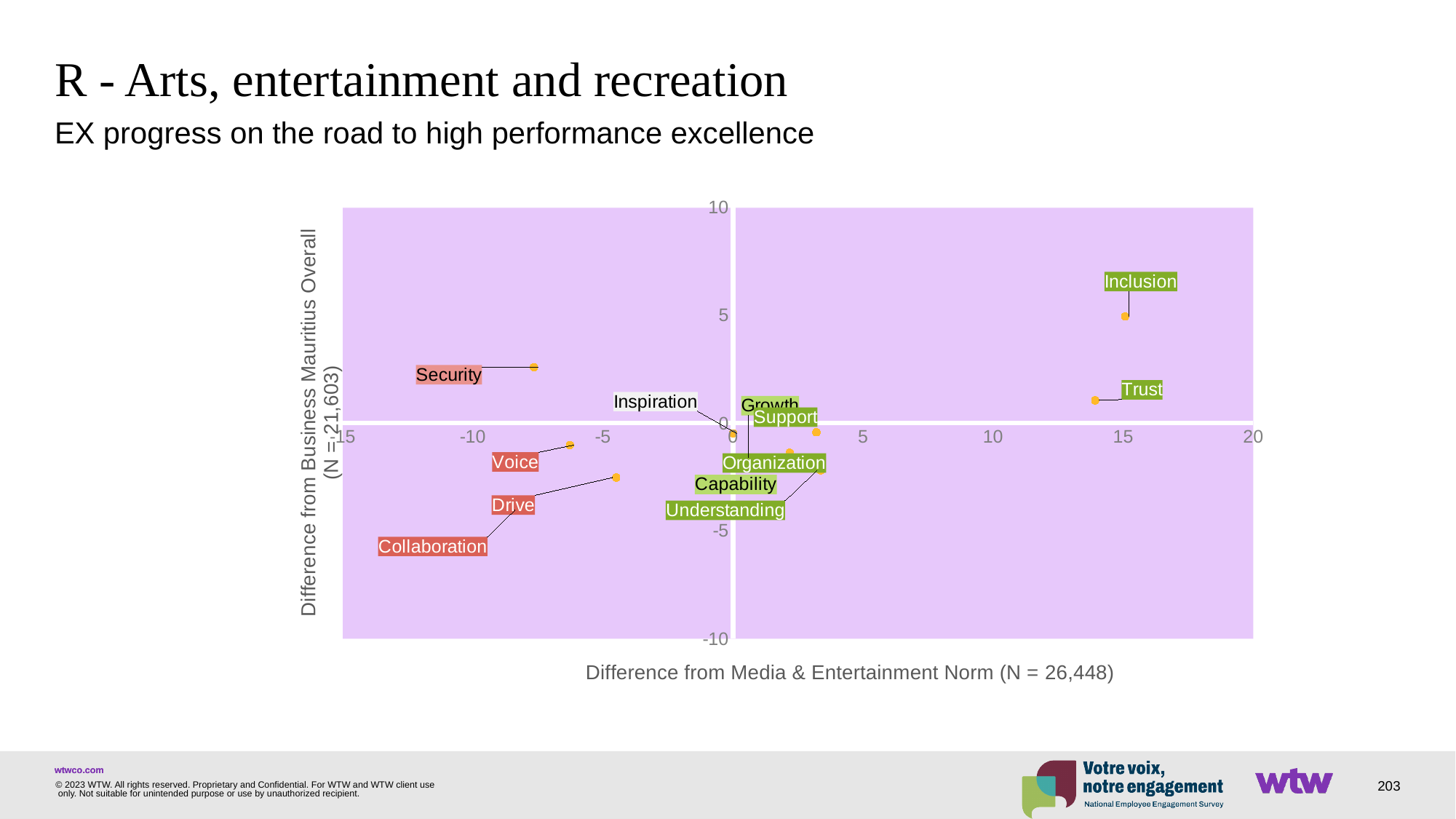
Which point is higher on the vertical axis, Inclusion or Trust? Inclusion How many labeled points are plotted on the chart? 12 Is the horizontal-axis value for Security greater or less than -5? less Is the vertical-axis value for Trust greater or less than 5? less Is the horizontal-axis value for Inclusion greater or less than 10? greater Which labeled point has the lowest value on the horizontal axis? Collaboration Which point is further right on the horizontal axis, Security or Voice? Voice What kind of chart is shown on the slide? scatter chart What is the title of the horizontal axis of the chart? Difference from Media & Entertainment Norm (N = 26,448) What is the title of the vertical axis of the chart? Difference from Business Mauritius Overall (N = 21,603) Which labeled point has the highest value on the vertical axis? Inclusion